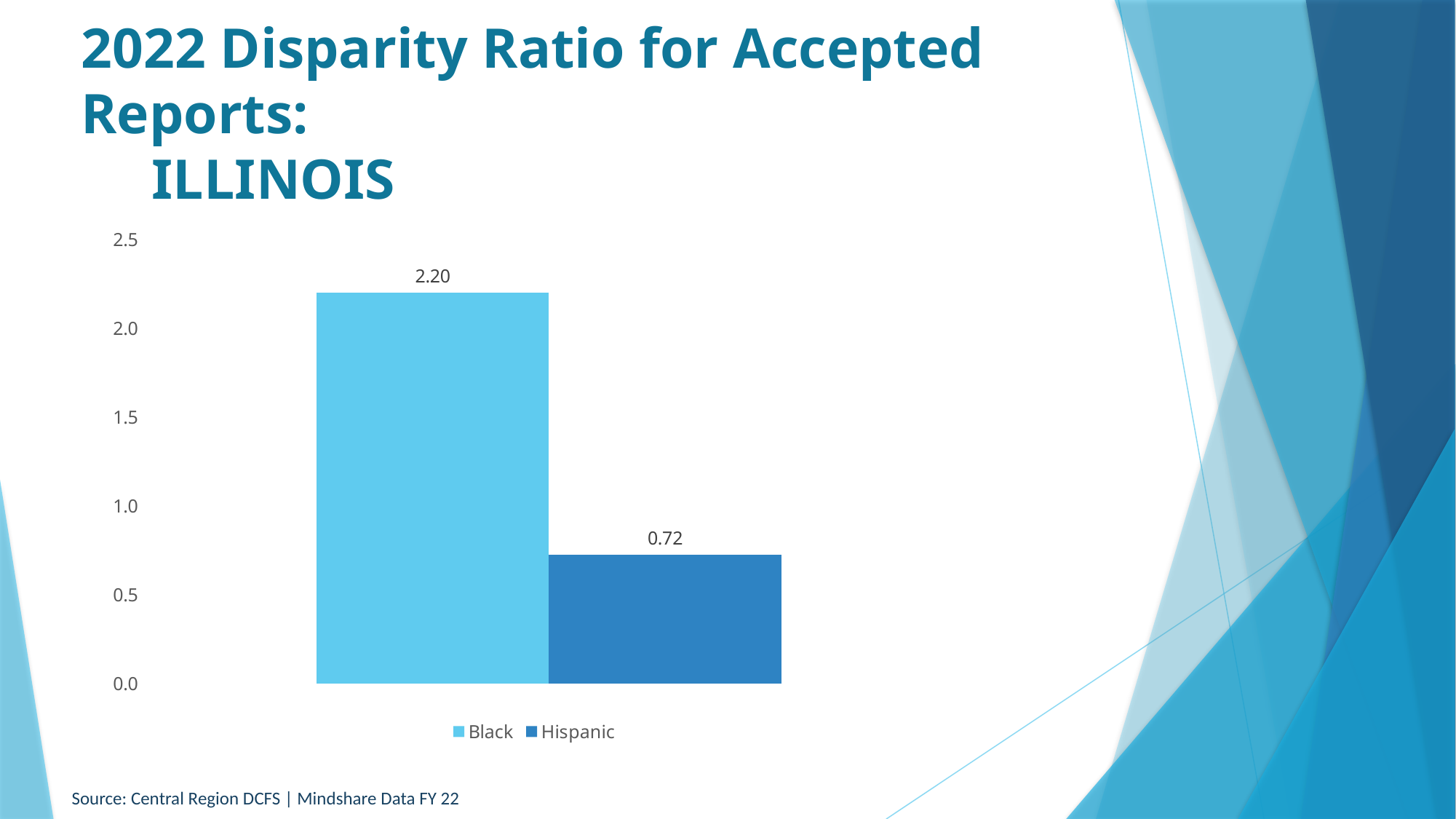
What is the disparity ratio for Black in the chart? 2.20 What kind of chart is shown on the slide? bar chart Which group has the lower disparity ratio? Hispanic Is the value for Black greater or less than 2.0? greater How many bars are plotted in the chart? 2 What is the highest value shown on the vertical axis? 2.5 How many series does the legend list? 2 What is the difference between the Black and Hispanic disparity ratios? 1.48 What is the disparity ratio for Hispanic in the chart? 0.72 Which group has the higher disparity ratio? Black Is the value for Hispanic greater or less than 1.0? less Is the disparity ratio for Black larger or smaller than the ratio for Hispanic? larger